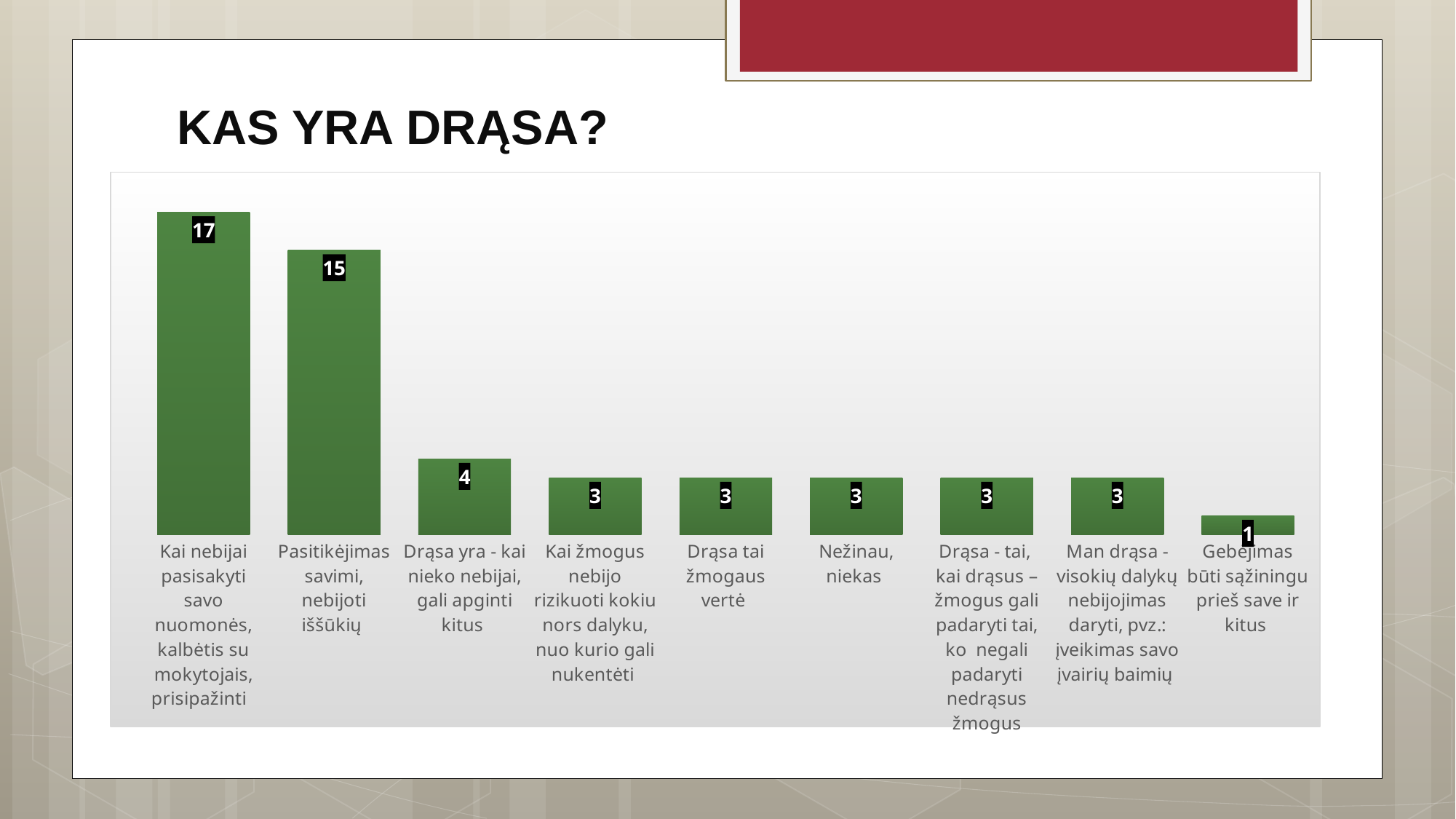
What is the value for "Pasitikėjimas savimi, nebijoti iššūkių"? 15 Which category has the lowest value? Gebėjimas būti sąžiningu prieš save ir kitus What is the value for "Drąsa yra - kai nieko nebijai, gali apginti kitus"? 4 What kind of chart is shown on the slide? Bar chart How many categories have a value of 3? 5 What is the title of the slide above the chart? KAS YRA DRĄSA? Which is larger: the value for "Pasitikėjimas savimi, nebijoti iššūkių" or the value for "Drąsa tai žmogaus vertė"? Pasitikėjimas savimi, nebijoti iššūkių Which category has the highest value? Kai nebijai pasisakyti savo nuomonės, kalbėtis su mokytojais, prisipažinti What is the difference between the values for "Drąsa yra - kai nieko nebijai, gali apginti kitus" and "Gebėjimas būti sąžiningu prieš save ir kitus"? 3 How many categories are shown in the chart? 9 What is the value for "Nežinau, niekas"? 3 What is the difference between the values for "Kai nebijai pasisakyti savo nuomonės, kalbėtis su mokytojais, prisipažinti" and "Pasitikėjimas savimi, nebijoti iššūkių"? 2